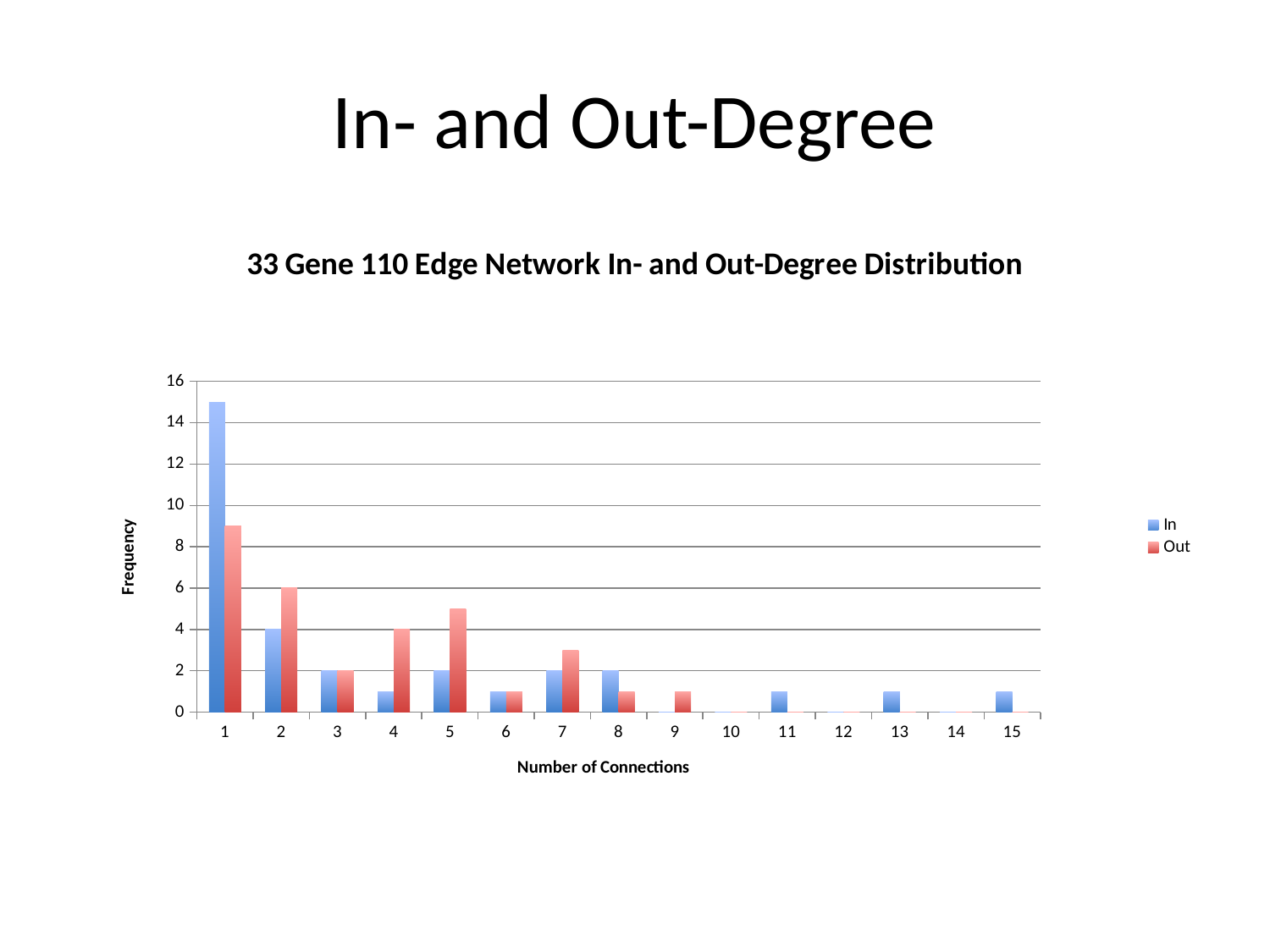
How many categories are shown on the x axis (Number of Connections)? 15 What type of chart is shown on the slide? bar chart What is the Out frequency for 2 connections? 6 Is the In frequency for 1 connection greater or less than 14? greater For 5 connections, which series has the larger frequency, In or Out? Out Is the Out frequency for 1 connection greater or less than 8? greater Which number of connections has the highest In frequency? 1 What is the Out frequency for 4 connections? 4 What is the In frequency for 2 connections? 4 What is the title of the chart? 33 Gene 110 Edge Network In- and Out-Degree Distribution What is the In frequency for 8 connections? 2 How many series does the legend list? 2